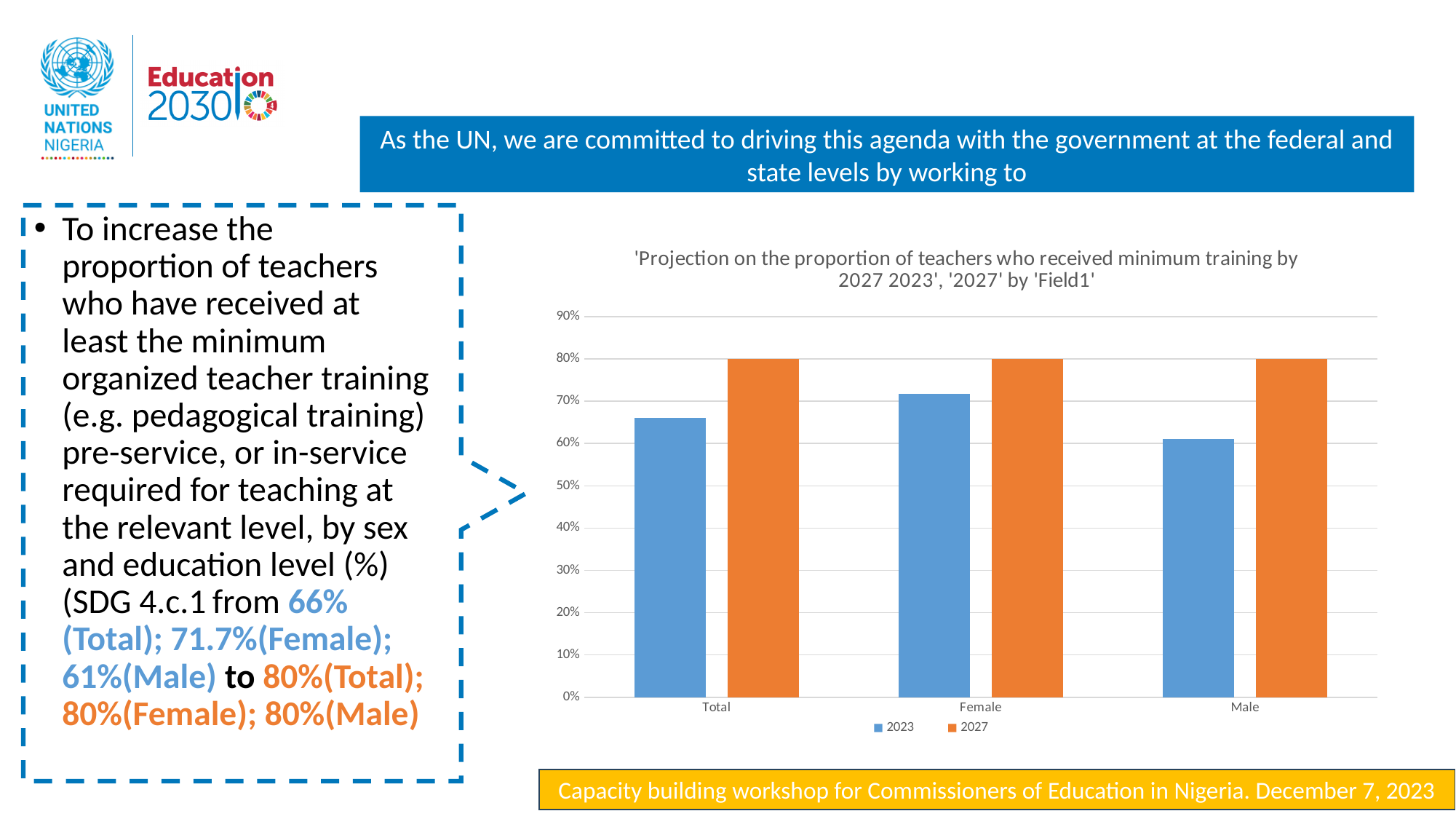
What kind of chart is shown on the slide? bar chart Is the 2023 value for Total greater or less than 70%? less Is the 2023 value for Female greater or less than 60%? greater What is the 2027 value for Total in the chart? 80% For the Male category, which is larger: the 2023 value or the 2027 value? 2027 What is the 2027 value for Male in the chart? 80% How many series does the chart's legend list? 2 Which category has the highest 2023 value? Female Which category has the lowest 2023 value? Male Is the 2023 value for Male greater or less than 70%? less How many categories are shown on the x axis of the chart? 3 What are the two entries in the chart's legend? 2023 and 2027